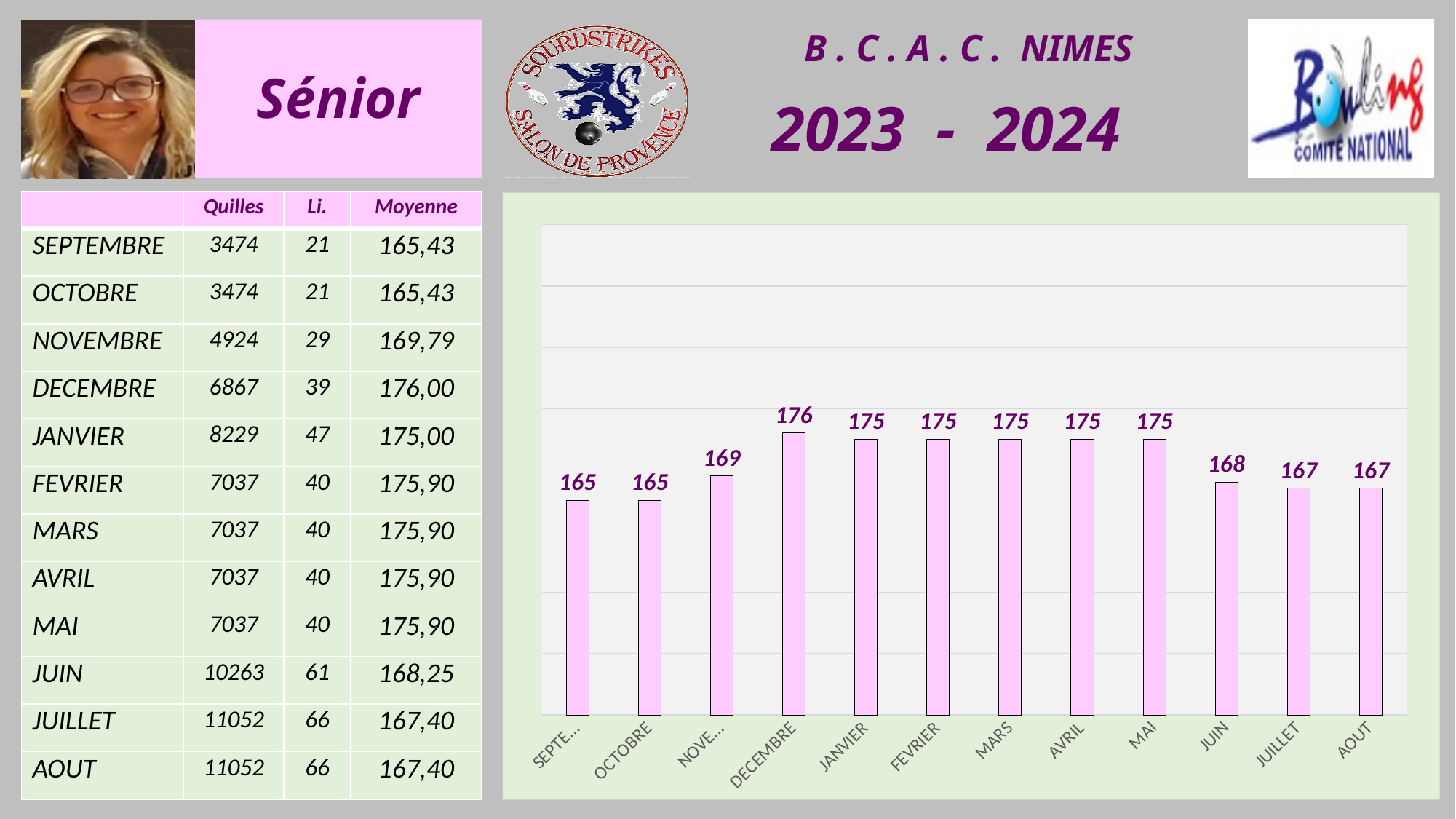
What is the difference between the values for JANVIER and AOUT in the chart? 8 What is the difference between the values for DECEMBRE and JUIN in the chart? 8 How many bars are plotted in the chart? 12 What kind of chart is shown on the slide? bar chart Do the values rise or fall from DECEMBRE to AOUT in the chart? fall Which is larger in the chart, the value for MAI or the value for JUIN? MAI What is the value shown for DECEMBRE in the chart? 176 Which month has the highest bar in the chart? DECEMBRE What is the lowest value labelled on the chart? 165 What is the value shown for JUIN in the chart? 168 What is the value shown for JUILLET in the chart? 167 What is the value shown for OCTOBRE in the chart? 165